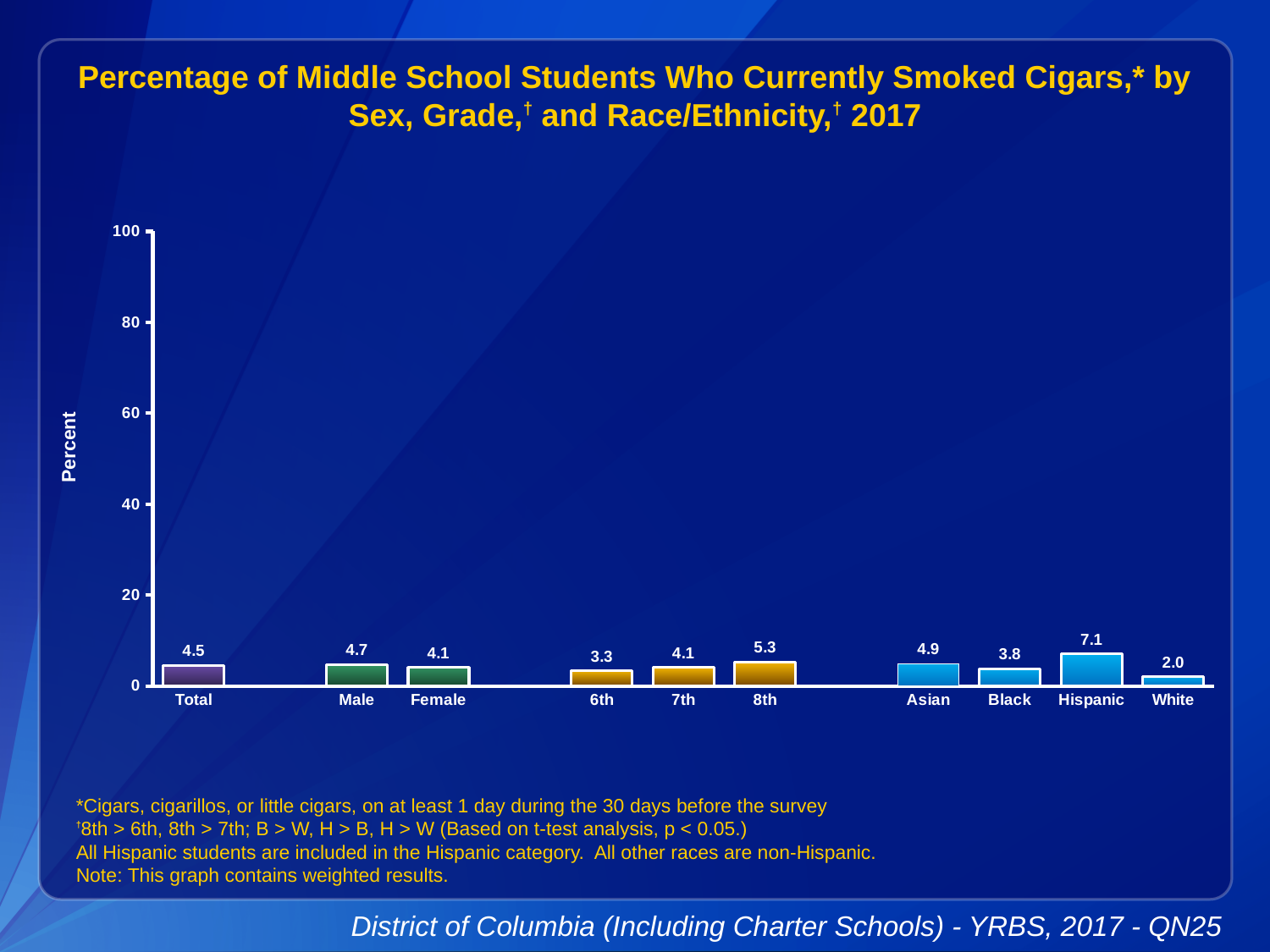
Which category has the highest value? Hispanic Is the value for Hispanic greater or less than 20? less What is the difference between the values for Male and Female? 0.6 Do the values rise or fall from 6th grade to 8th grade? rise Which is larger, the value for Asian or the value for Black? Asian How many categories are shown on the x axis? 10 What is the difference between the values for 8th grade and 6th grade? 2.0 What kind of chart is this? bar chart What is the value for 6th grade? 3.3 What is the value for Total? 4.5 Which category has the lowest value? White What is the value for Hispanic students? 7.1